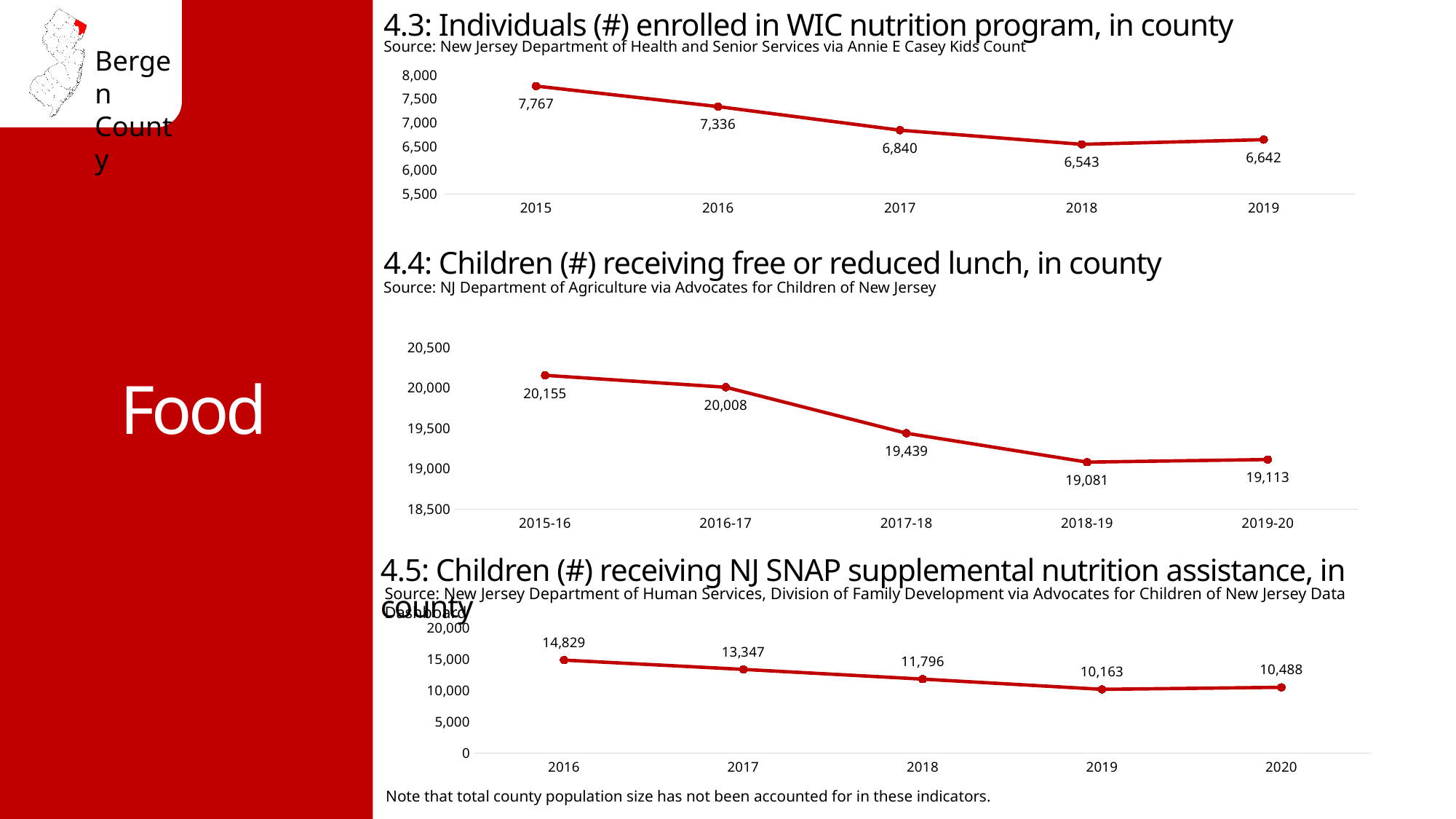
What kind of chart is '4.3: Individuals (#) enrolled in WIC nutrition program, in county'? line chart In the chart '4.3: Individuals (#) enrolled in WIC nutrition program, in county', what is the difference between the 2015 and 2019 values? 1,125 In the chart '4.5: Children (#) receiving NJ SNAP supplemental nutrition assistance, in county', what is the difference between the 2017 and 2018 values? 1,551 In the chart '4.3: Individuals (#) enrolled in WIC nutrition program, in county', what is the value for 2017? 6,840 In the chart '4.5: Children (#) receiving NJ SNAP supplemental nutrition assistance, in county', what is the value for 2016? 14,829 In the chart '4.4: Children (#) receiving free or reduced lunch, in county', what is the value for 2017-18? 19,439 In the chart '4.5: Children (#) receiving NJ SNAP supplemental nutrition assistance, in county', what is the overall trend from 2016 to 2019? falling In the chart '4.4: Children (#) receiving free or reduced lunch, in county', is the value for 2019-20 larger or smaller than the value for 2018-19? larger In the chart '4.4: Children (#) receiving free or reduced lunch, in county', how many data points are plotted? 5 In the chart '4.3: Individuals (#) enrolled in WIC nutrition program, in county', which year has the lowest value? 2018 In the chart '4.5: Children (#) receiving NJ SNAP supplemental nutrition assistance, in county', which year has the lowest value? 2019 In the chart '4.4: Children (#) receiving free or reduced lunch, in county', which school year has the highest value? 2015-16